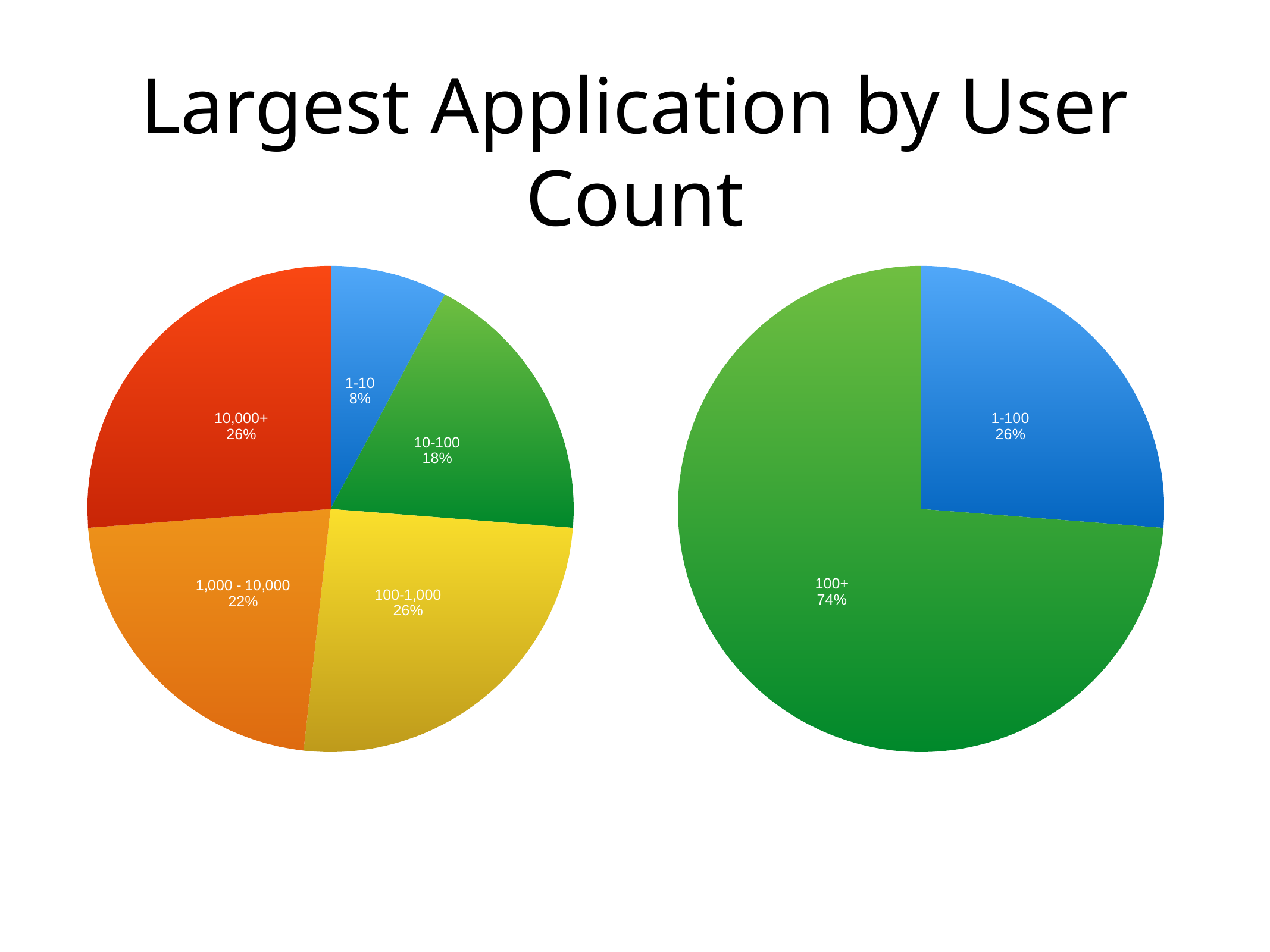
In the right pie chart, which category has the largest share? 100+ In the right pie chart, what share does the 1-100 slice have? 26% In the left pie chart, what is the difference between the 10-100 share and the 1-10 share? 10% In the right pie chart, how many slices are there? 2 In the left pie chart, what share does the 1-10 slice have? 8% In the left pie chart, which category has the smallest share? 1-10 In the left pie chart, which is larger, the 1,000 - 10,000 slice or the 10-100 slice? 1,000 - 10,000 In the left pie chart, how many slices are there? 5 In the right pie chart, what share does the 100+ slice have? 74% What type of chart is shown on the right of the slide? Pie chart